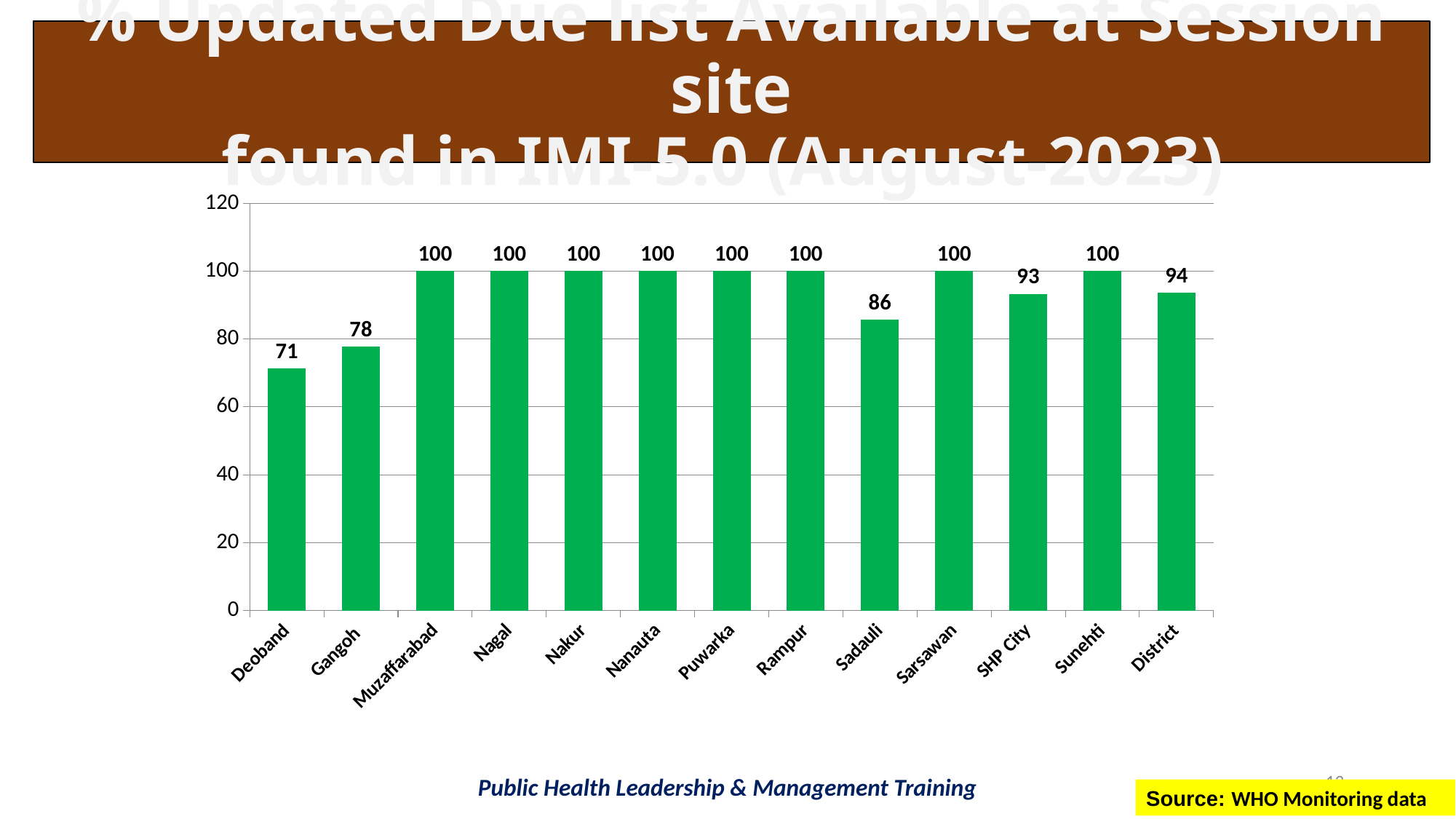
What is the value for Deoband? 71 What is the value for SHP City? 93 What kind of chart is shown on the slide? bar chart Is the value for Gangoh greater or less than 80? less What is the difference between the values for Nagal and Sadauli? 14 Which category has the lowest value? Deoband Which is larger, the value for SHP City or the value for District? District How many categories are shown on the x axis? 13 What is the difference between the values for Gangoh and Deoband? 7 What is the value for Sadauli? 86 What is the value for District? 94 How many categories have a value of 100? 8